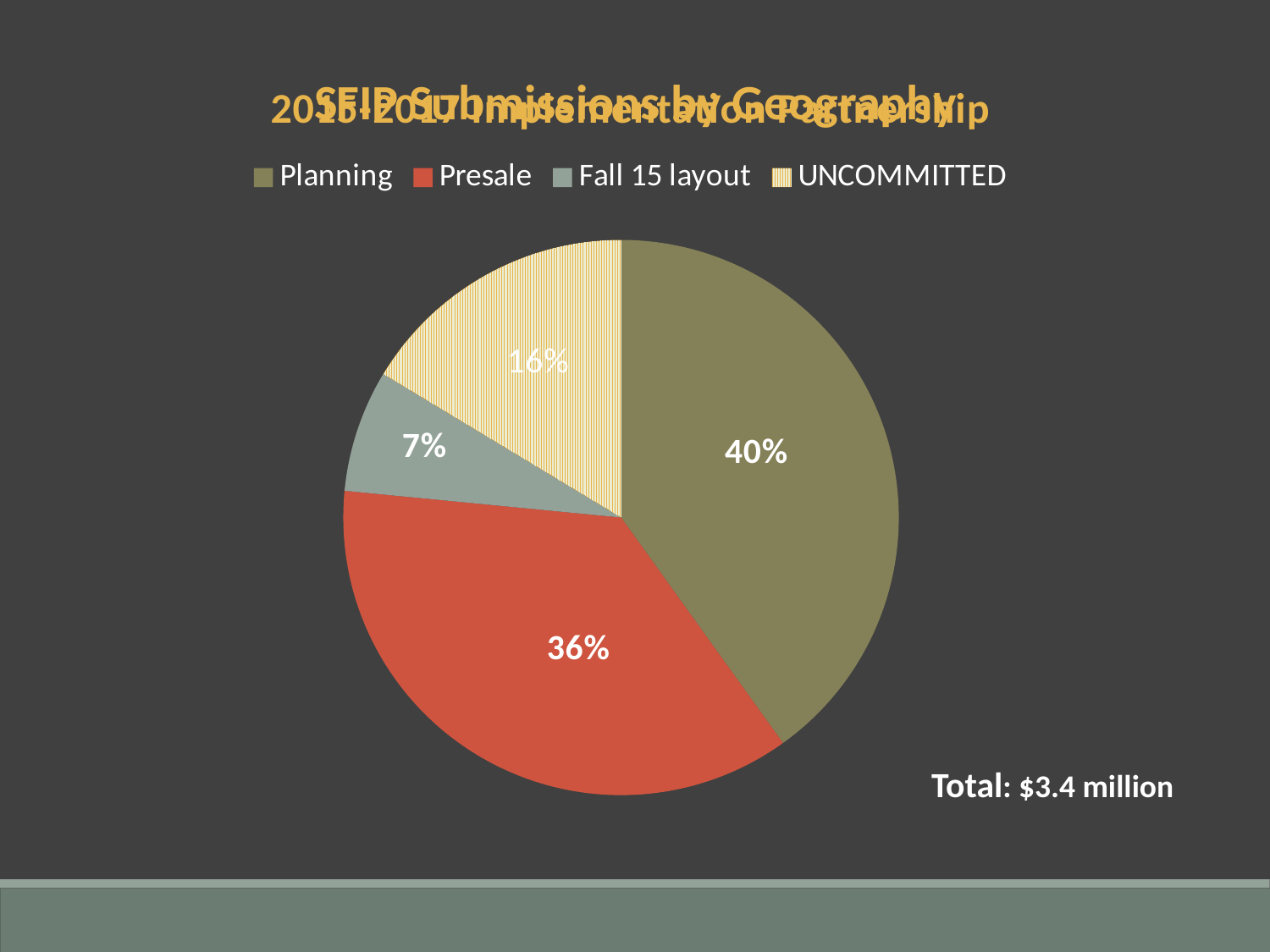
What share of the pie does Presale represent? 36% What share of the pie does Planning represent? 40% What share of the pie does UNCOMMITTED represent? 16% What kind of chart is shown on the slide? pie chart Which slice is larger, UNCOMMITTED or Fall 15 layout? UNCOMMITTED Which category has the smallest slice of the pie? Fall 15 layout What total amount is stated next to the pie chart? $3.4 million What is the difference in percentage points between the Planning and Presale slices? 4 What is the difference in percentage points between the UNCOMMITTED and Fall 15 layout slices? 9 How many categories does the pie chart have? 4 Which category has the largest slice of the pie? Planning